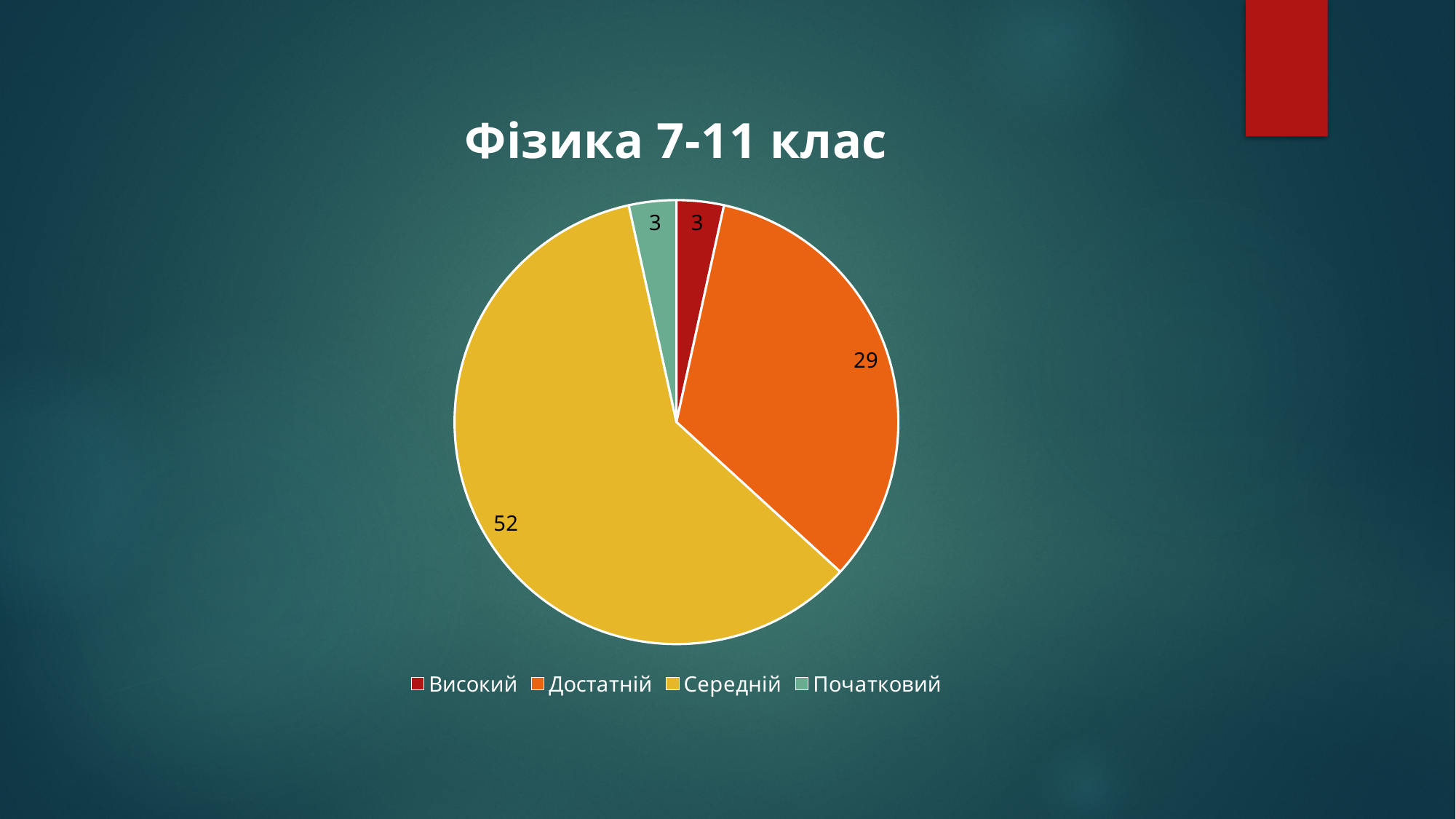
What is the value for Достатній? 29 What is the difference between the values for Середній and Достатній? 23 Which is larger, the value for Достатній or the value for Початковий? Достатній What is the title of the chart? Фізика 7-11 клас What is the total of all the values shown in the pie chart? 87 How many slices does the pie chart have? 4 What is the value for Початковий? 3 Which category has the largest slice of the pie? Середній What colour is the slice for Середній? yellow What is the value for Середній? 52 What is the value for Високий? 3 What kind of chart is shown on the slide? pie chart